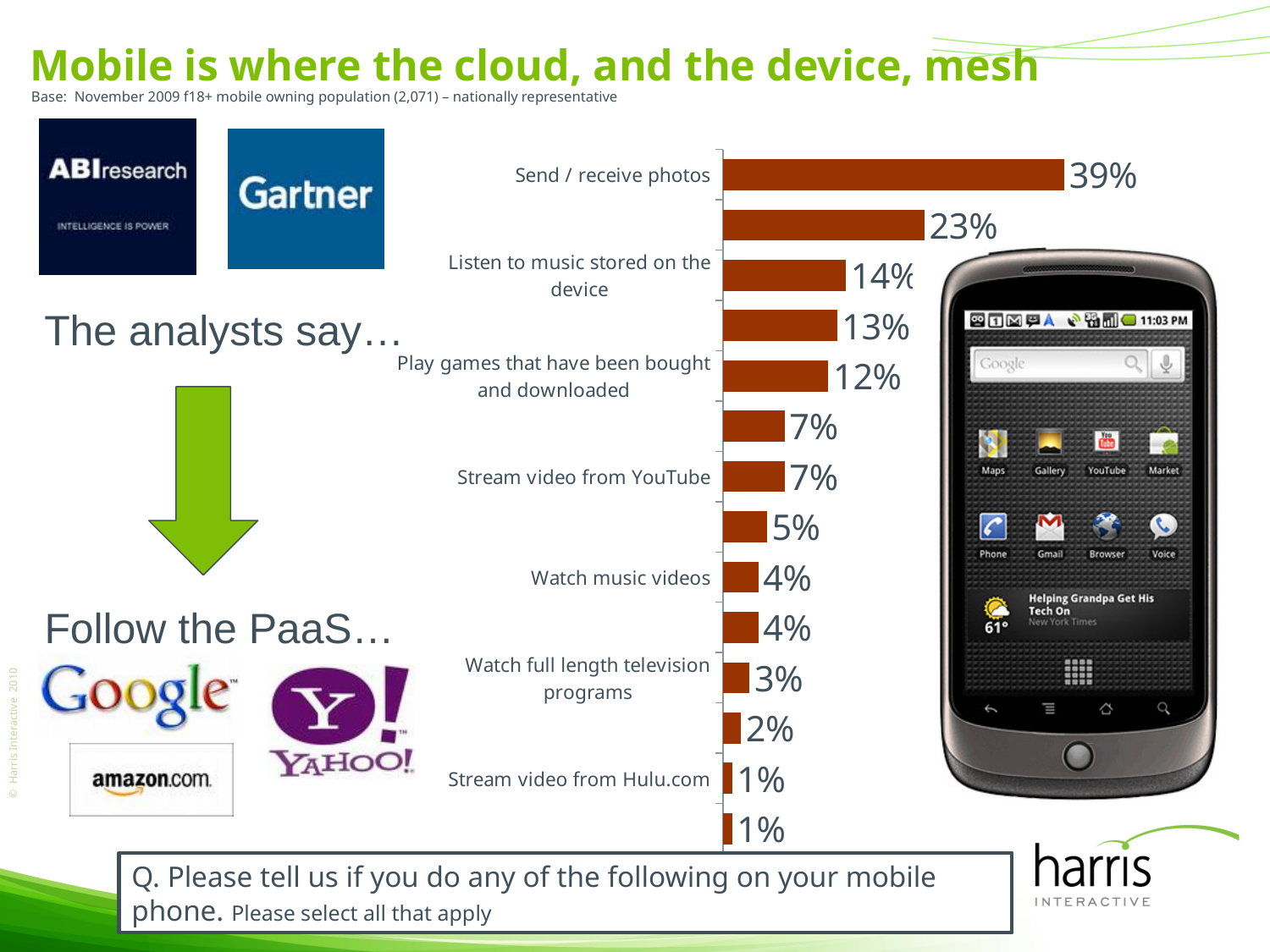
What is the value for 'Play games that have been bought and downloaded'? 12% What is the value for 'Stream video from Hulu.com'? 1% What is the value for 'Listen to music stored on the device'? 14% What is the difference between the values for 'Send / receive photos' and 'Listen to music stored on the device'? 25 percentage points What kind of chart is shown on the slide? Bar chart How many bars are plotted in the chart? 14 Which activity has the highest value in the chart? Send / receive photos Which is larger: the value for 'Play games that have been bought and downloaded' or for 'Stream video from YouTube'? Play games that have been bought and downloaded What percentage stream video from YouTube on their mobile phone? 7% Do the bar values increase or decrease going from the top of the chart to the bottom? Decrease What is the value for 'Watch full length television programs'? 3% What percentage of respondents send / receive photos on their mobile phone? 39%